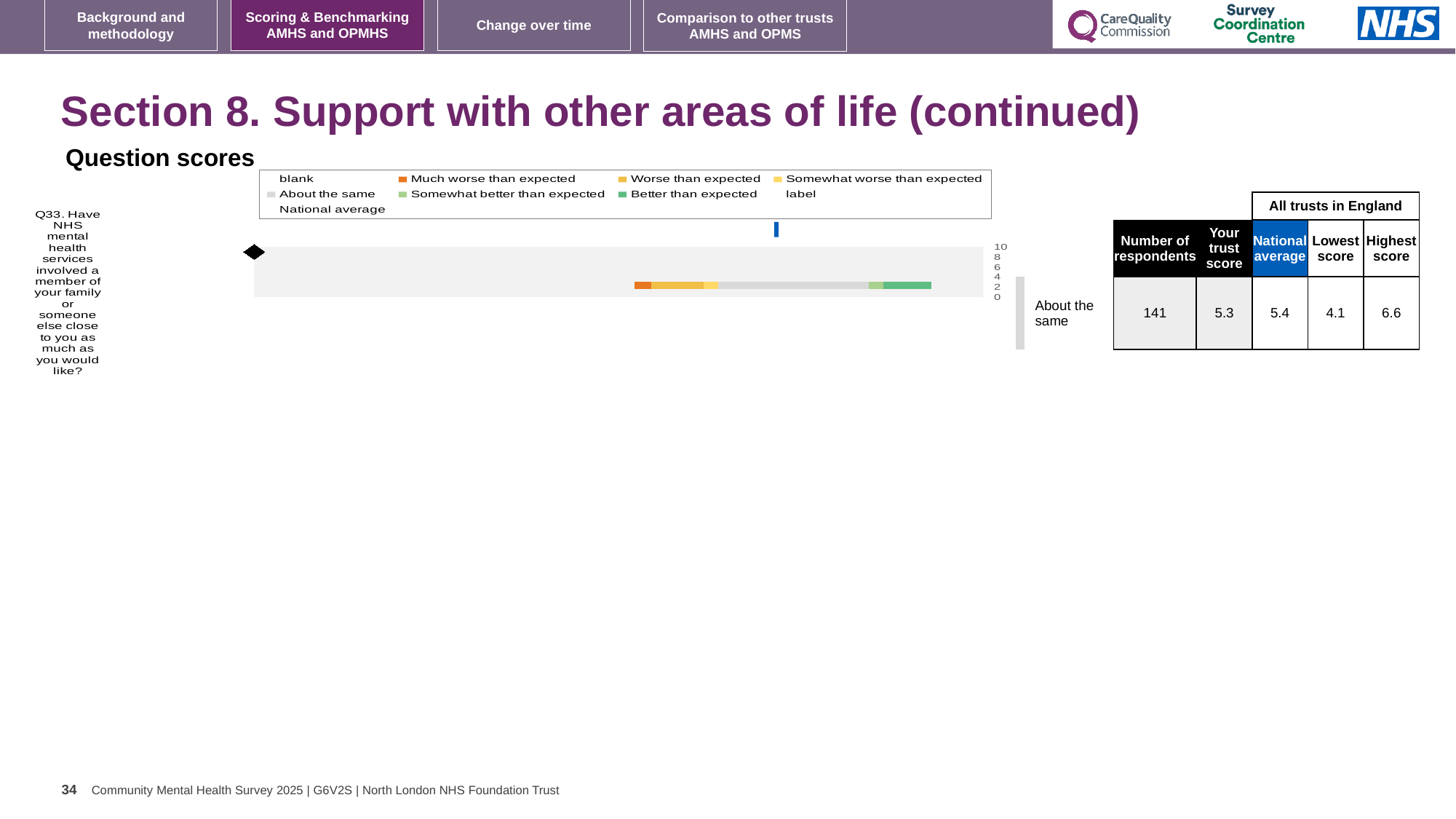
In the table beside the chart, what is the highest score among all trusts in England for Q33? 6.6 In the table beside the chart, which is larger for Q33: the trust score or the national average? national average What kind of chart is shown under 'Question scores'? bar chart How many survey questions are plotted in the chart? 1 What is the highest value shown on the chart's axis? 10 In the table beside the chart, what is the lowest score among all trusts in England for Q33? 4.1 In the table beside the chart, what is the trust's score for Q33? 5.3 What benchmark category is shown for Q33 next to the chart? About the same Which question is plotted in the chart? Q33. Have NHS mental health services involved a member of your family or someone else close to you as much as you would like? In the table beside the chart, what is the number of respondents for Q33? 141 In the table beside the chart, what is the national average for Q33? 5.4 What colour does the legend use for 'Much worse than expected'? orange